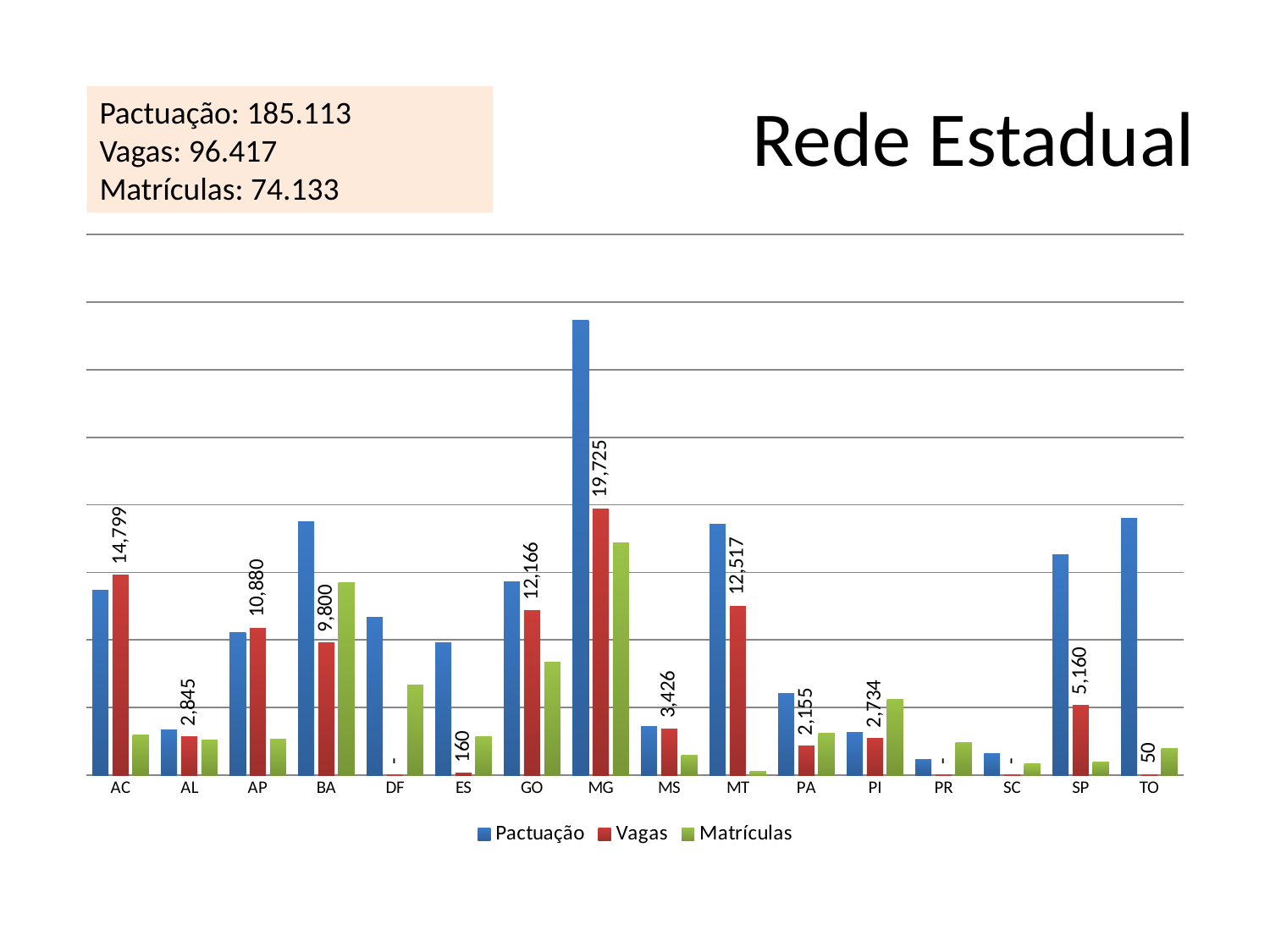
How many series does the legend list? 3 How many states are shown on the x axis? 16 Which state has the highest Pactuação bar? MG Which state has the highest Vagas value? MG What is the Vagas value for ES? 160 What is the difference between the Vagas values for MG and AC? 4,926 What is the difference between the Vagas values for MT and GO? 351 What is the Vagas value for SP? 5,160 What is the Vagas value for MG? 19,725 What is the Vagas value for AC? 14,799 What kind of chart is shown on the slide? Bar chart Which has a larger Vagas value, AP or BA? AP